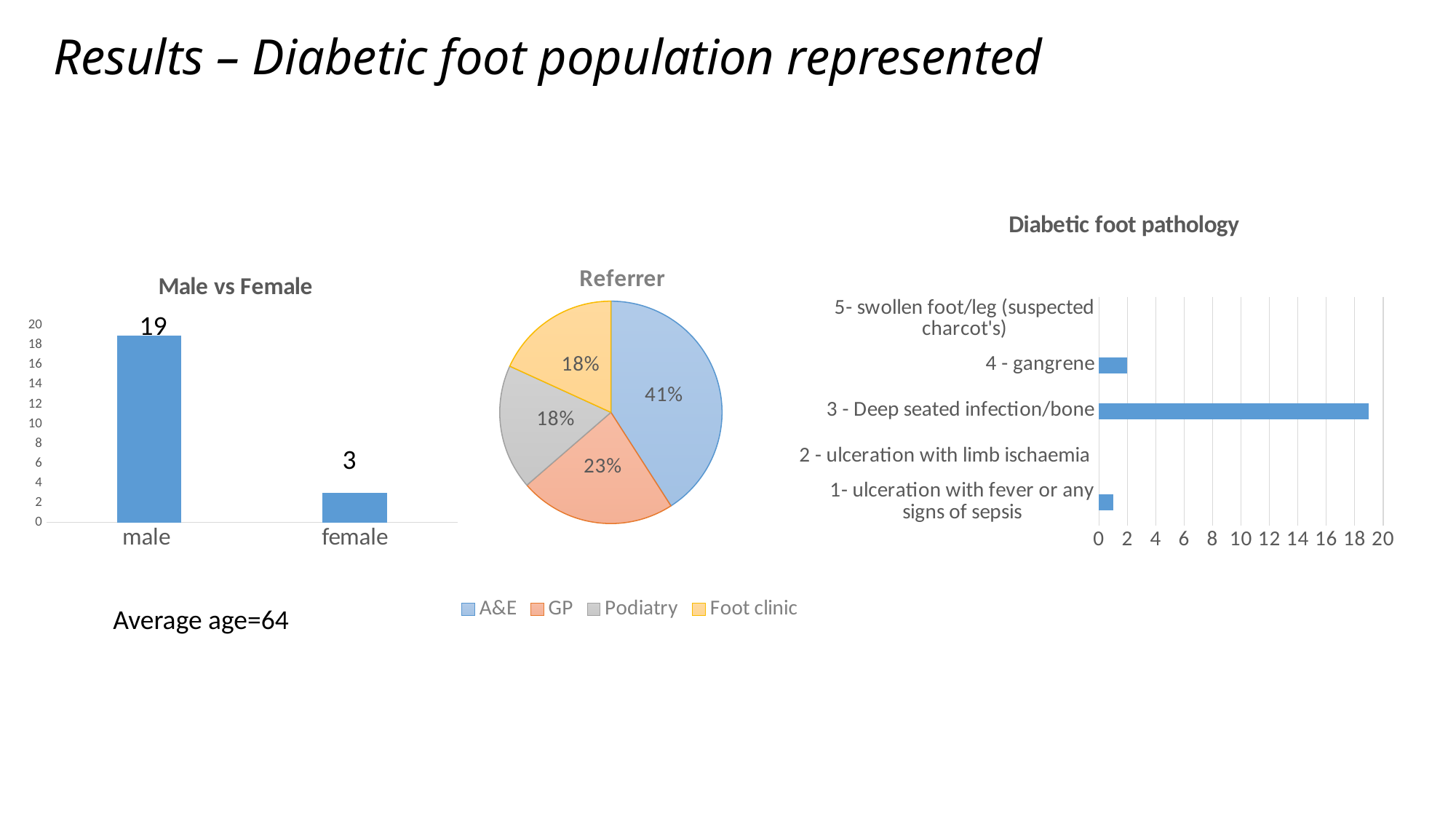
How many categories are shown in the Diabetic foot pathology chart? 5 In the Diabetic foot pathology chart, is the value for 3 - Deep seated infection/bone greater or less than 10? greater What kind of chart is the Diabetic foot pathology chart? bar chart In the Referrer pie chart, what share does A&E have? 41% In the Male vs Female chart, what is the value for female? 3 In the Referrer pie chart, which referrer has the largest share? A&E In the Male vs Female chart, what is the value for male? 19 How many entries does the legend of the Referrer pie chart list? 4 In the Diabetic foot pathology chart, which category has the highest value? 3 - Deep seated infection/bone In the Male vs Female chart, which category is higher, male or female? male In the Male vs Female chart, what is the difference between the male and female values? 16 In the Referrer pie chart, what share does GP have? 23%